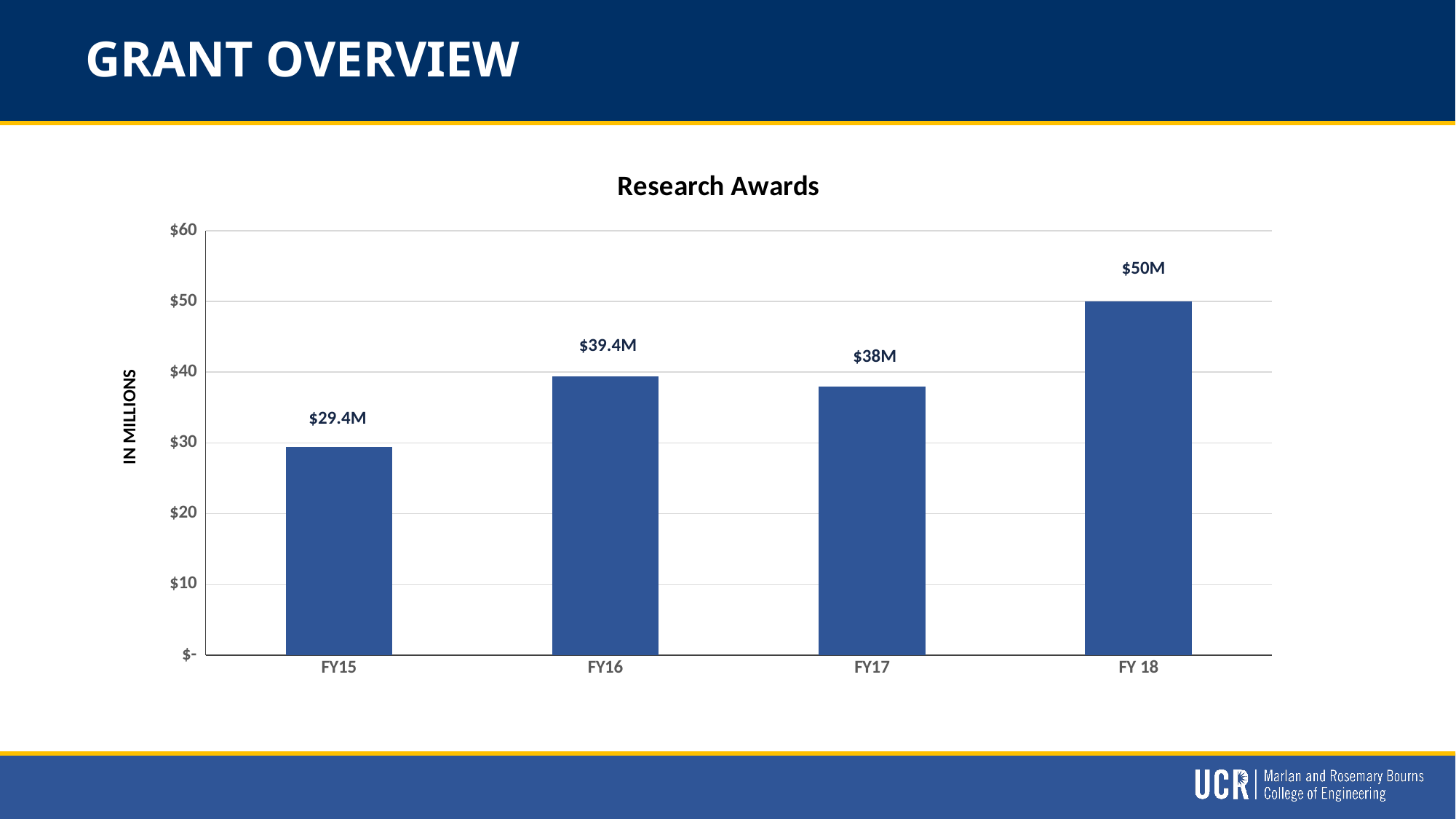
Which fiscal year has the highest research awards? FY 18 What is the value of research awards for FY17? $38M What is the difference in research awards between FY16 and FY17? $1.4M How many fiscal years are shown in the chart? 4 What is the value of research awards for FY 18? $50M What is the value of research awards for FY16? $39.4M What is the title of the chart? Research Awards What is the difference in research awards between FY 18 and FY15? $20.6M What type of chart is used to show Research Awards? Bar chart Which fiscal year has the lowest research awards? FY15 Which has larger research awards, FY16 or FY17? FY16 What is the value of research awards for FY15? $29.4M